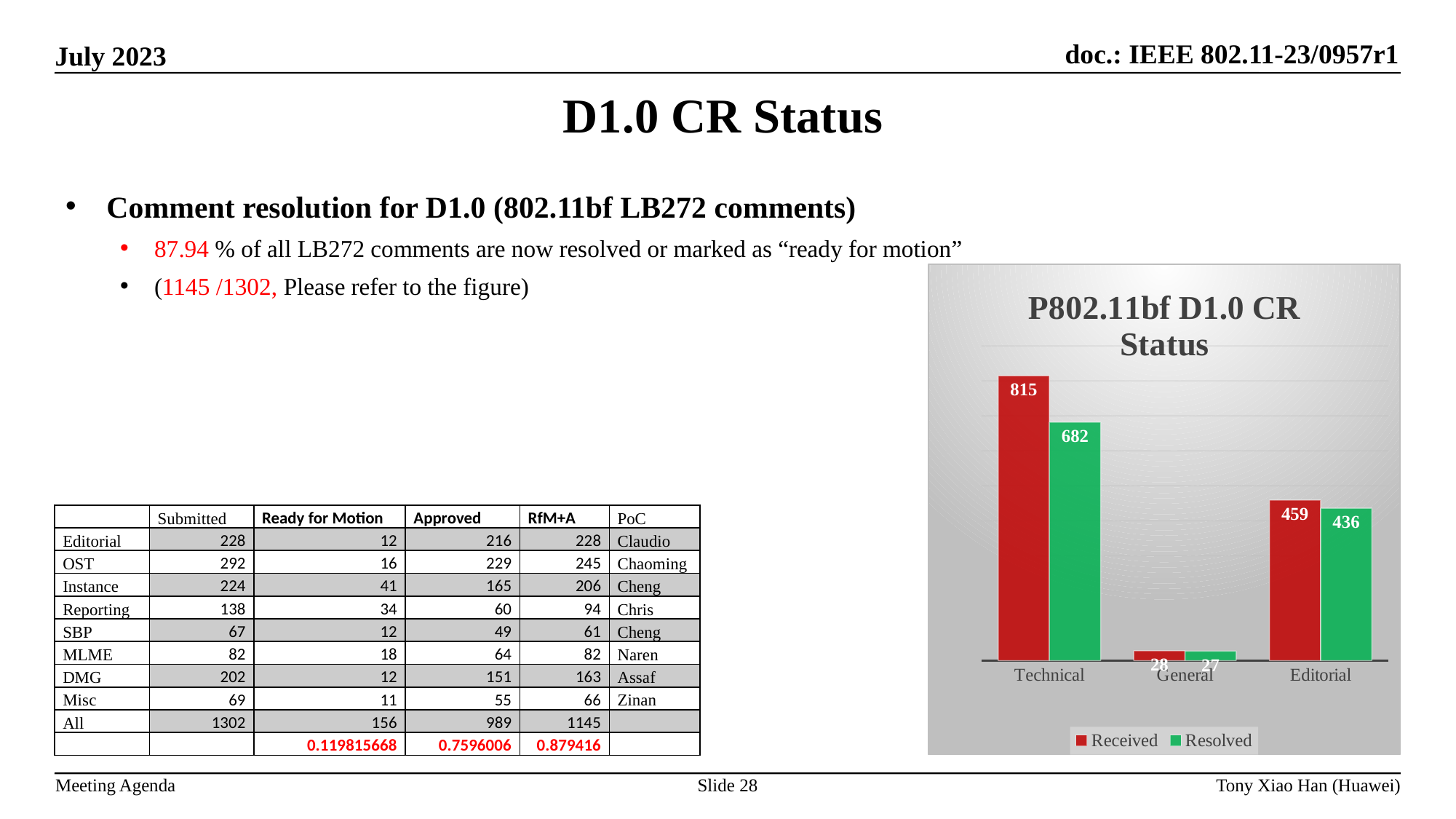
In the P802.11bf D1.0 CR Status chart, is the Received value for Technical or for Editorial larger? Technical What is the Received value for Technical in the P802.11bf D1.0 CR Status chart? 815 What type of chart is the P802.11bf D1.0 CR Status chart? Bar chart What is the Resolved value for Editorial in the P802.11bf D1.0 CR Status chart? 436 Which category has the lowest Resolved value in the P802.11bf D1.0 CR Status chart? General What is the difference between Received and Resolved for Editorial in the P802.11bf D1.0 CR Status chart? 23 Which category has the highest Received value in the P802.11bf D1.0 CR Status chart? Technical What is the Received value for General in the P802.11bf D1.0 CR Status chart? 28 How many series does the legend of the P802.11bf D1.0 CR Status chart list? 2 What is the difference between Received and Resolved for Technical in the P802.11bf D1.0 CR Status chart? 133 What is the Resolved value for Technical in the P802.11bf D1.0 CR Status chart? 682 How many categories are shown on the x axis of the P802.11bf D1.0 CR Status chart? 3